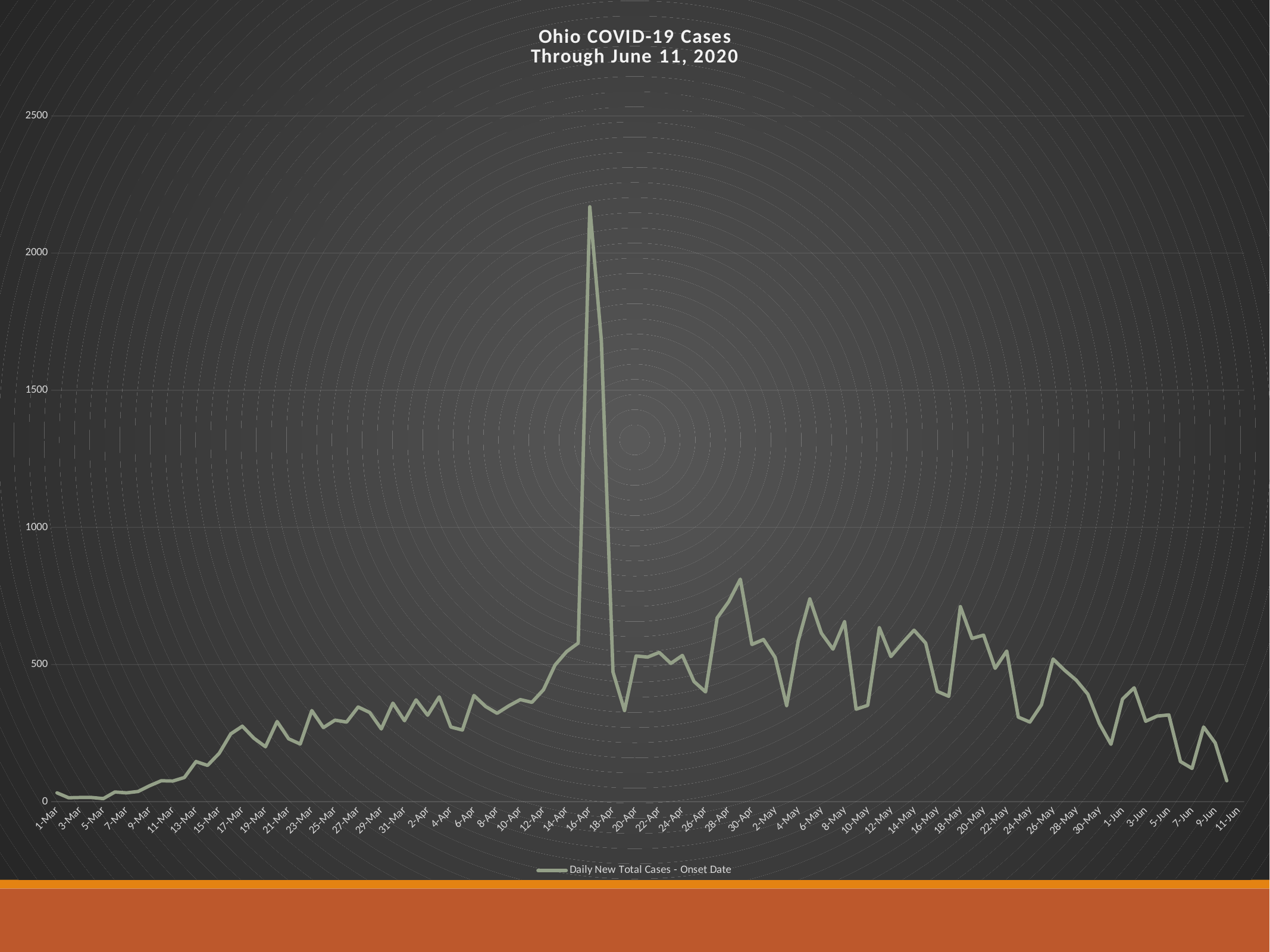
What is the title of the chart? Ohio COVID-19 Cases Through June 11, 2020 Is the value for 28-Apr greater or less than 500? greater Which date has the larger value, 16-Apr or 1-Mar? 16-Apr Do the values generally rise or fall from 26-May to 11-Jun? fall Is the value for 1-Mar greater or less than 500? less On which date does the line reach its highest value? 16-Apr What kind of chart is shown on the slide? line chart Is the value for 16-Apr greater or less than 2000? greater Do the values generally rise or fall from 1-Mar to 17-Mar? rise What is the name of the series shown in the legend? Daily New Total Cases - Onset Date How many series does the legend list? 1